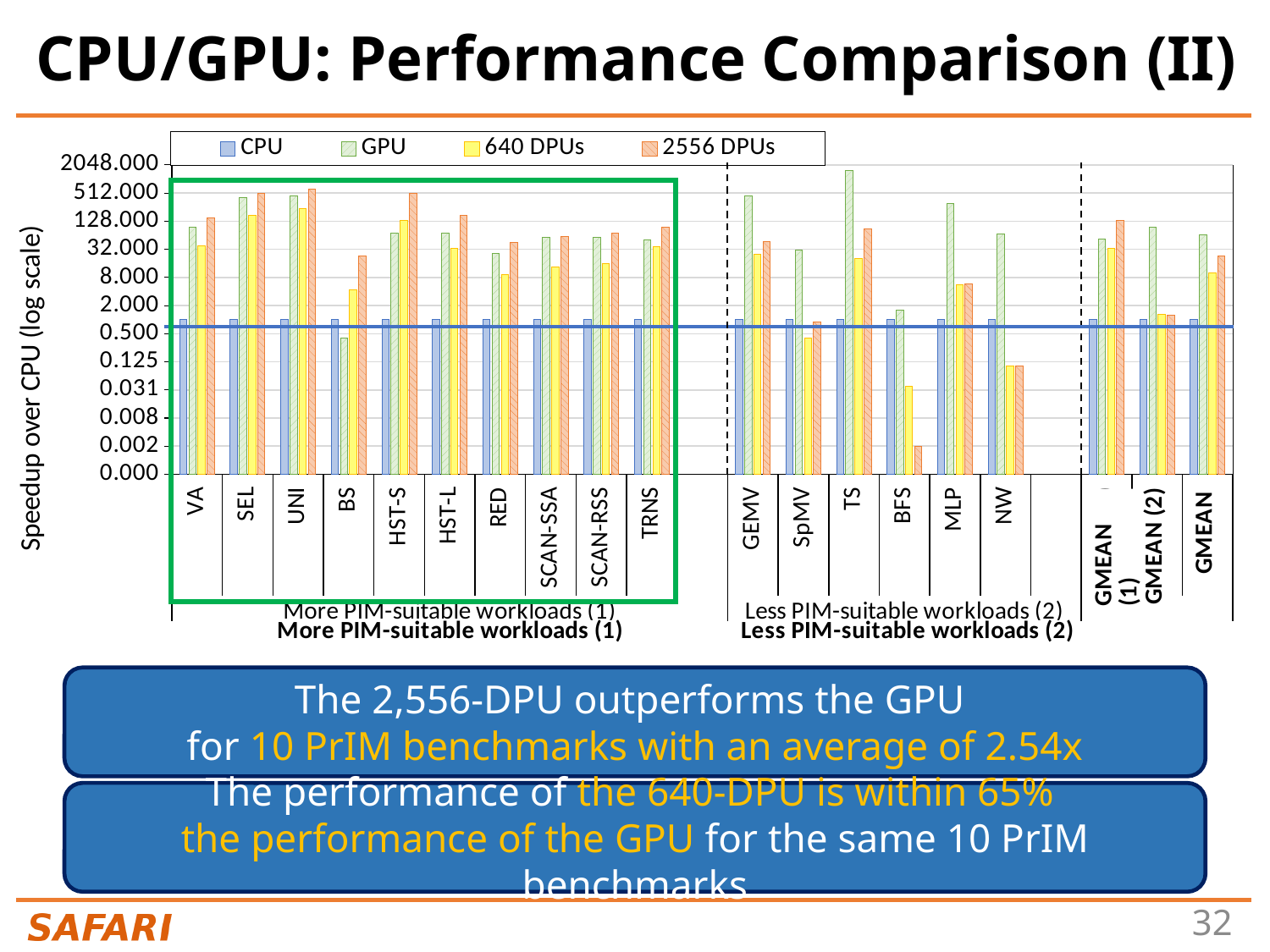
How many workload categories are plotted along the x axis of the chart? 19 Which category has the lowest 2556 DPUs bar in the chart? BFS How many series does the chart legend list? 4 What kind of chart is shown on the slide? bar chart Which category has the lowest GPU bar in the chart? BS Is the GPU value for TS greater or less than 512? greater Is the 640 DPUs value for BS greater or less than 8? less For TS, which is larger: the GPU value or the 2556 DPUs value? GPU What are the four series listed in the chart legend? CPU, GPU, 640 DPUs, 2556 DPUs Which category has the highest GPU bar in the chart? TS What is the label of the chart's y axis? Speedup over CPU (log scale) For BS, which is larger: the GPU value or the 2556 DPUs value? 2556 DPUs